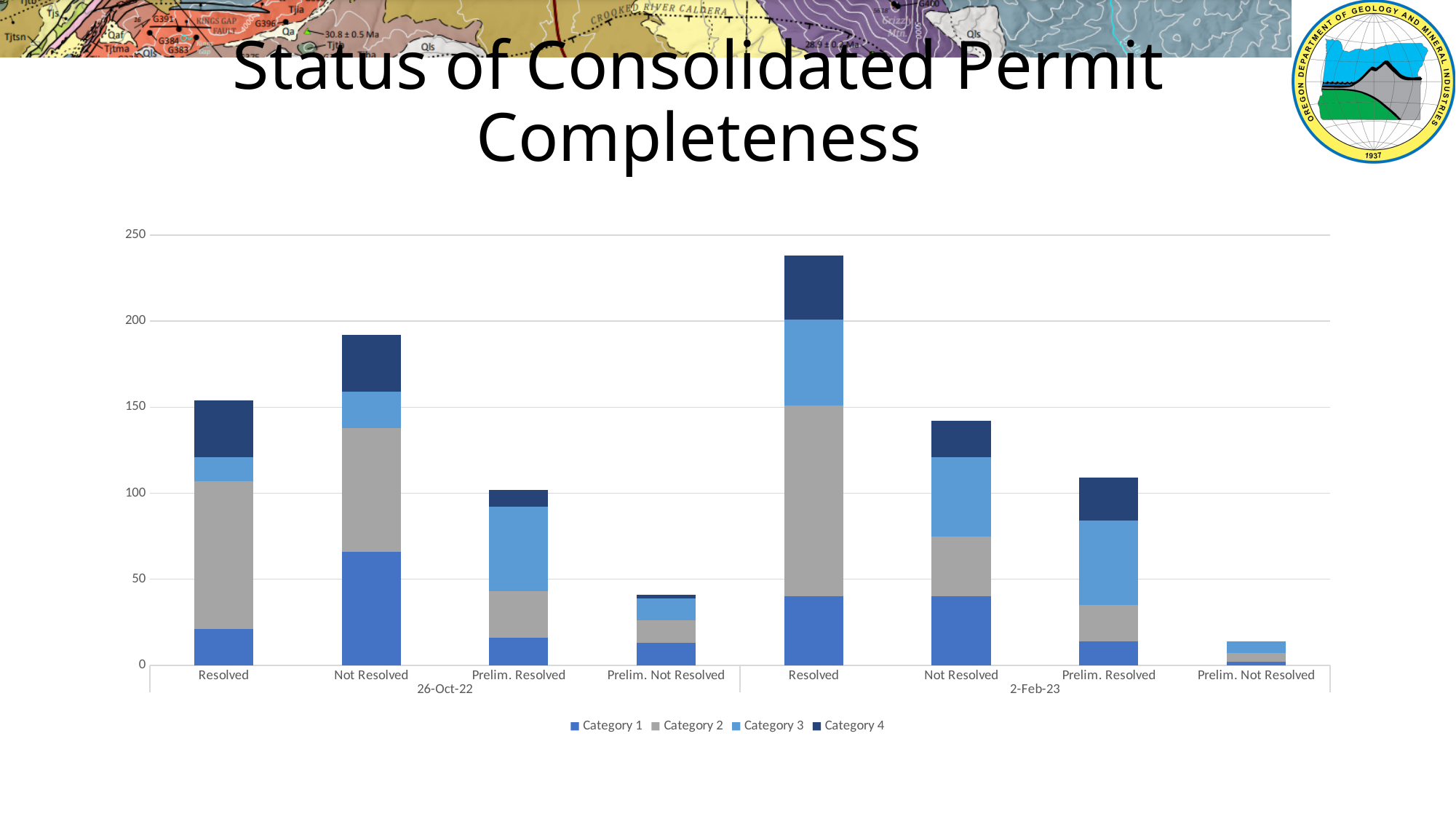
How many bars are plotted in the chart? 8 Is the total value for Not Resolved under 26-Oct-22 greater or less than 200? less Which is larger: the total for Not Resolved under 26-Oct-22 or the total for Not Resolved under 2-Feb-23? Not Resolved under 26-Oct-22 Is the total value for Prelim. Not Resolved under 2-Feb-23 greater or less than 50? less What are the two date groups shown on the x axis? 26-Oct-22 and 2-Feb-23 Is the total value for Resolved under 2-Feb-23 greater or less than 200? greater Which bar has the highest total value? Resolved (2-Feb-23) What kind of chart is shown on the slide? Stacked bar chart Which bar has the lowest total value? Prelim. Not Resolved (2-Feb-23) How many series does the legend list? 4 Which is larger: the total for Resolved under 26-Oct-22 or the total for Resolved under 2-Feb-23? Resolved under 2-Feb-23